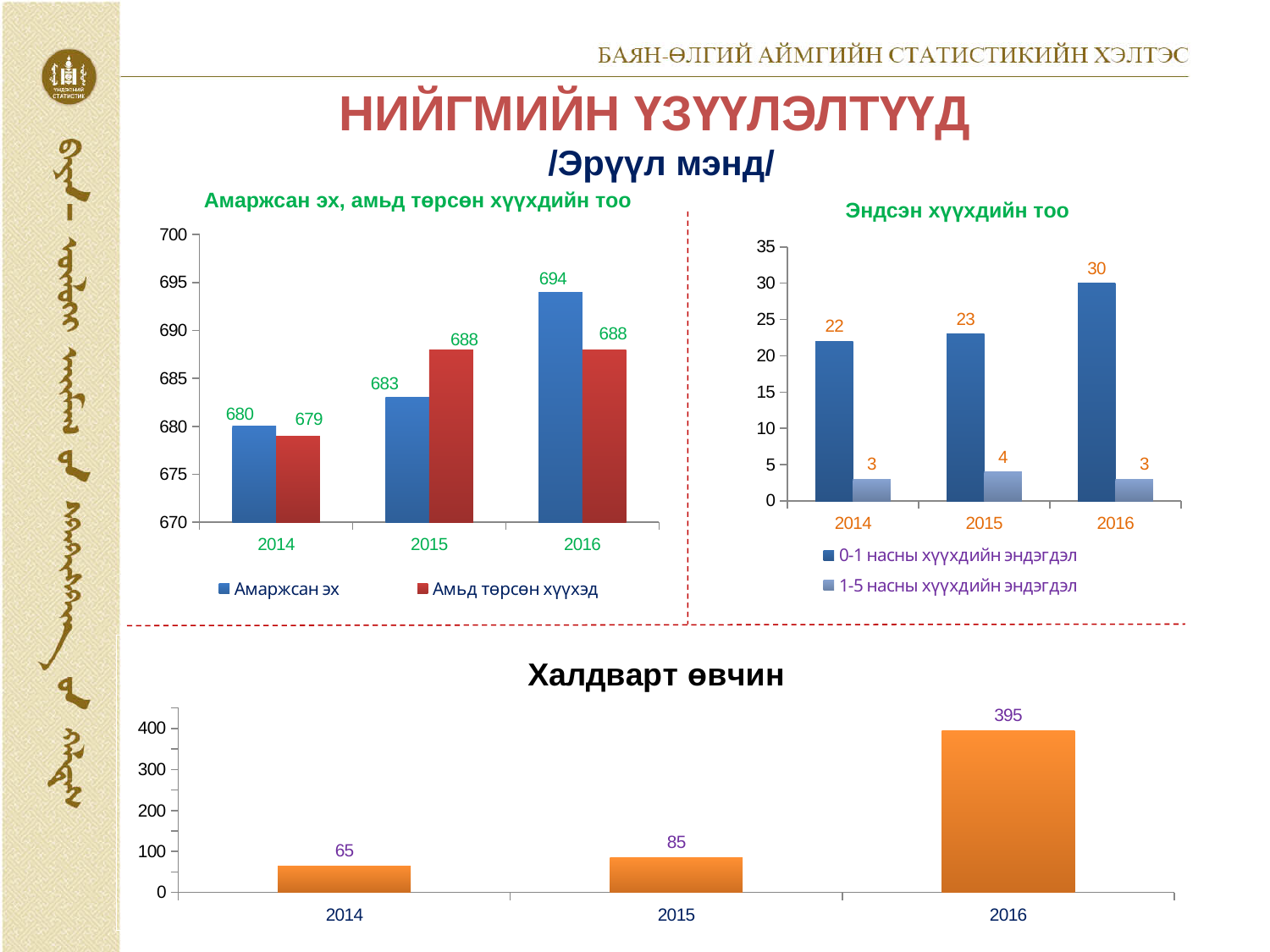
In the chart 'Амаржсан эх, амьд төрсөн хүүхдийн тоо', what is the difference between Амаржсан эх and Амьд төрсөн хүүхэд in 2015? 5 In the chart 'Эндсэн хүүхдийн тоо', how many years are shown on the x axis? 3 What kind of chart is 'Халдварт өвчин'? bar chart In the chart 'Амаржсан эх, амьд төрсөн хүүхдийн тоо', does the value for Амаржсан эх rise or fall from 2014 to 2016? rise In the chart 'Халдварт өвчин', what is the value for 2016? 395 In the chart 'Эндсэн хүүхдийн тоо', what is the value for 0-1 насны хүүхдийн эндэгдэл in 2016? 30 In the chart 'Эндсэн хүүхдийн тоо', which year has the highest value for 1-5 насны хүүхдийн эндэгдэл? 2015 In the chart 'Амаржсан эх, амьд төрсөн хүүхдийн тоо', what is the value for Амаржсан эх in 2016? 694 In the chart 'Амаржсан эх, амьд төрсөн хүүхдийн тоо', what is the value for Амьд төрсөн хүүхэд in 2014? 679 In the chart 'Эндсэн хүүхдийн тоо', what is the difference between 0-1 насны and 1-5 насны хүүхдийн эндэгдэл in 2014? 19 In the chart 'Халдварт өвчин', which year has the lowest value? 2014 In the chart 'Амаржсан эх, амьд төрсөн хүүхдийн тоо', how many series does the legend list? 2